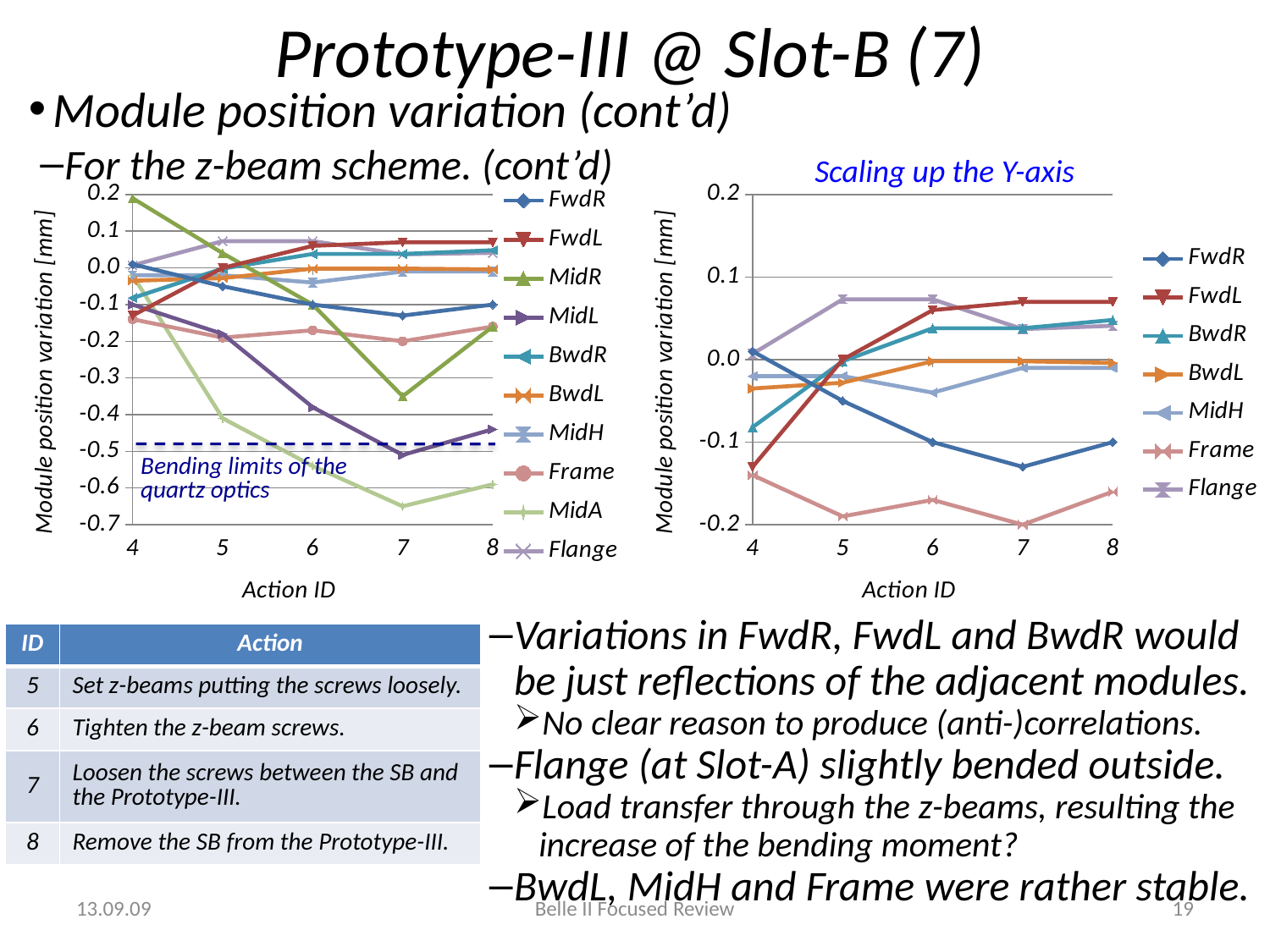
In the right chart (Scaling up the Y-axis), which series has the lowest value at Action ID 7? Frame In the right chart (Scaling up the Y-axis), is the value for FwdL at Action ID 8 greater or less than 0.0? greater How many Action ID points are plotted along the x axis of the right chart (Scaling up the Y-axis)? 5 In the right chart (Scaling up the Y-axis), does the FwdL series rise or fall from Action ID 4 to Action ID 8? rise In the left chart, which series has the lowest value at Action ID 7? MidA How many series does the legend of the right chart (Scaling up the Y-axis) list? 7 In the right chart (Scaling up the Y-axis), is the value for FwdR at Action ID 7 greater or less than -0.1? less What does the dashed horizontal line in the left chart represent, according to its label? Bending limits of the quartz optics In the left chart, which series has the highest value at Action ID 4? MidR In the left chart, which is larger at Action ID 7: the value for MidR or the value for MidA? MidR What kind of chart is the left chart on the slide? line chart How many series does the legend of the left chart list? 10